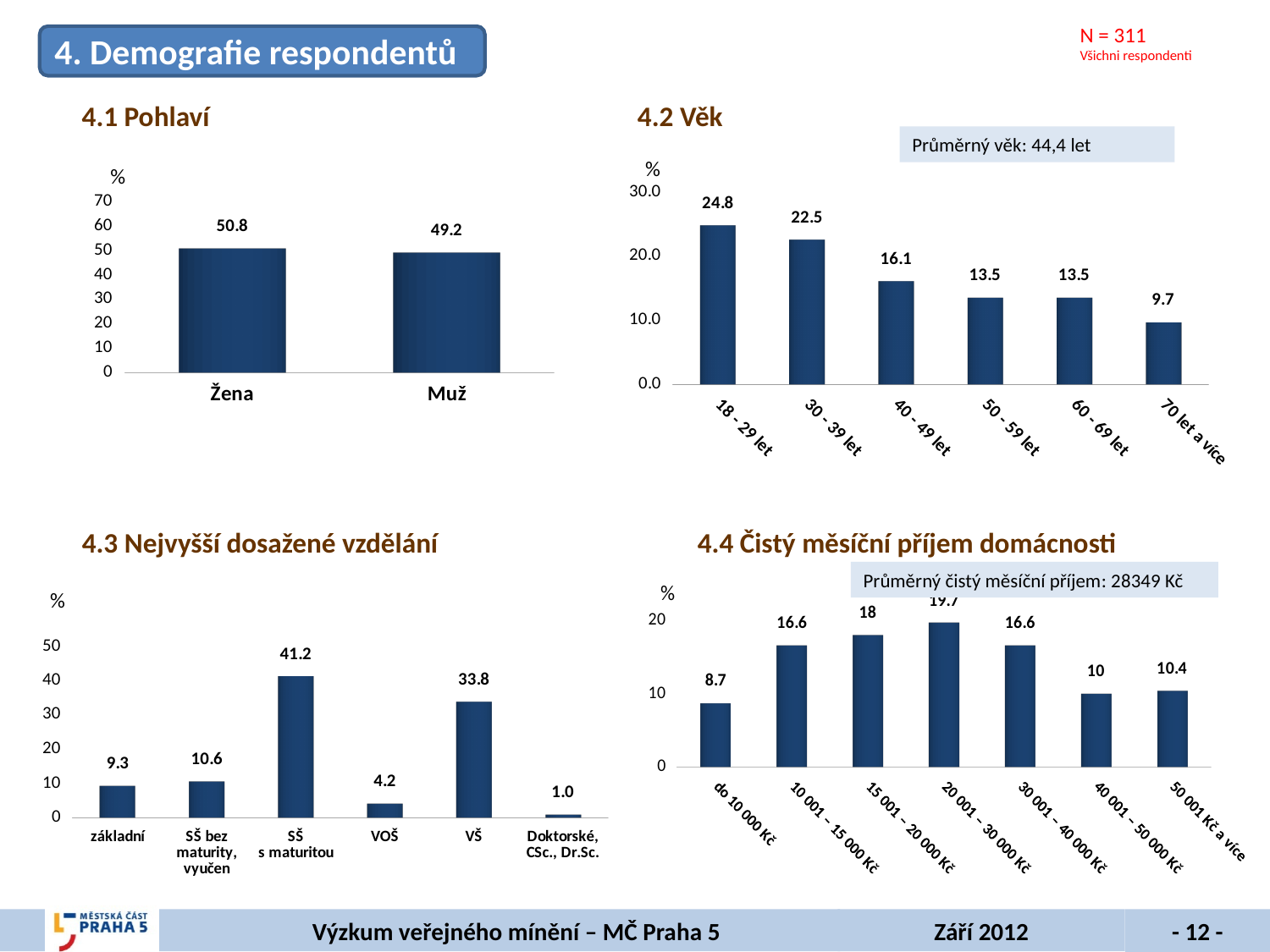
In the chart '4.2 Věk', how many age categories are shown? 6 In the chart '4.1 Pohlaví', what is the value for Žena? 50.8 In the chart '4.3 Nejvyšší dosažené vzdělání', what is the value for VŠ? 33.8 What type of chart is '4.4 Čistý měsíční příjem domácnosti'? bar chart In the chart '4.3 Nejvyšší dosažené vzdělání', what is the difference between SŠ s maturitou and VŠ? 7.4 In the chart '4.4 Čistý měsíční příjem domácnosti', what is the value for do 10 000 Kč? 8.7 In the chart '4.3 Nejvyšší dosažené vzdělání', which category has the lowest value? Doktorské, CSc., Dr.Sc. In the chart '4.2 Věk', what is the difference between the values for 18 - 29 let and 30 - 39 let? 2.3 In the chart '4.2 Věk', do the values rise or fall from left to right along the x axis? fall In the chart '4.2 Věk', what is the value for 70 let a více? 9.7 In the chart '4.2 Věk', which age group has the highest value? 18 - 29 let In the chart '4.1 Pohlaví', which category has the larger value, Žena or Muž? Žena